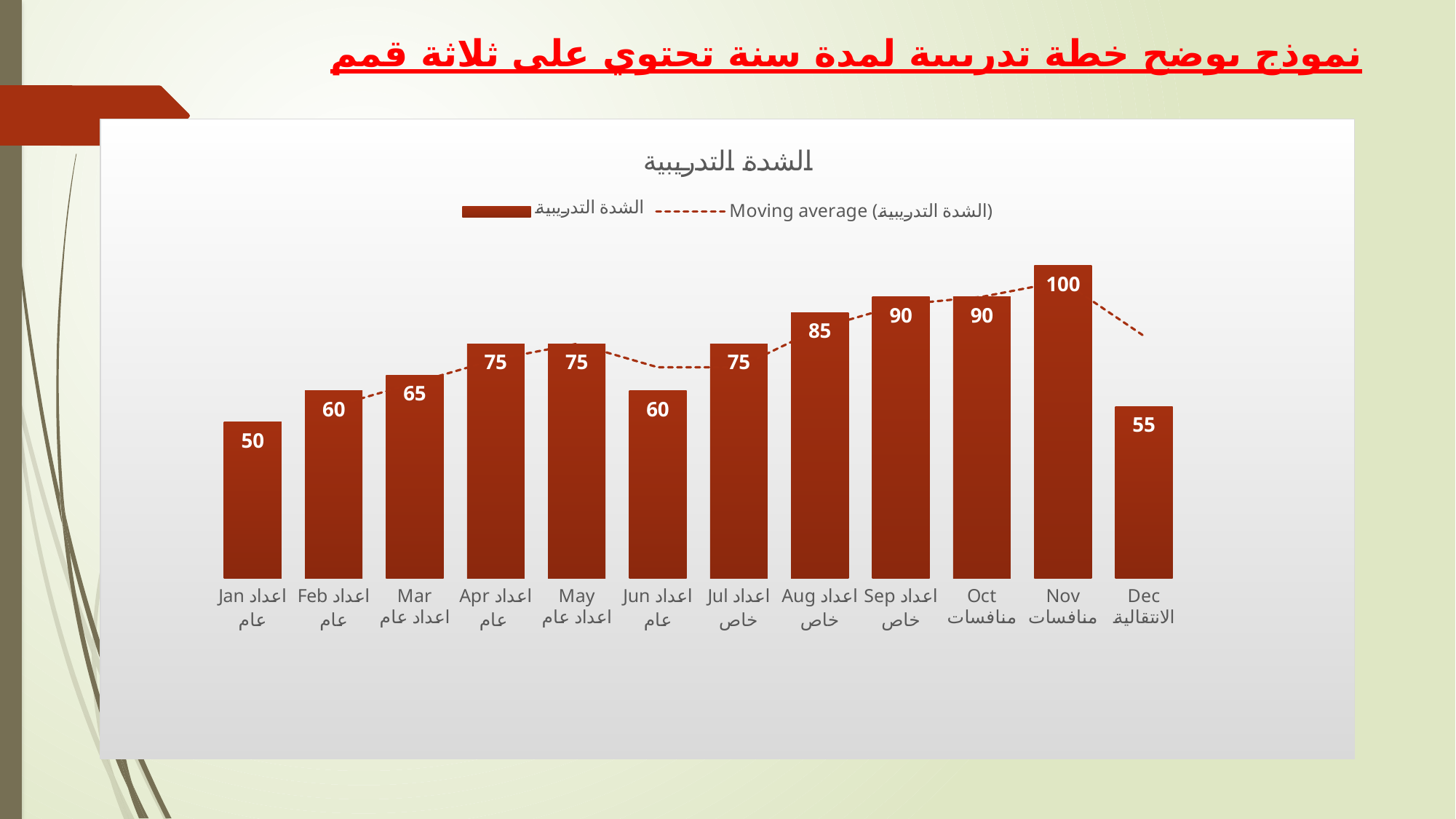
What kind of chart is shown on the slide? Bar chart What is the training intensity value for Nov? 100 What is the difference between the values for Nov and Dec? 45 What is the difference between the values for Jun and Jul? 15 What is the value shown for Jan? 50 Which month has the highest training intensity? Nov What is the value shown for Aug? 85 How many months (bars) are plotted in the chart? 12 How many series does the legend list? 2 Which month has the lowest training intensity? Jan What is the title of the chart? الشدة التدريبية Which is larger, the value for Mar or the value for Jun? Mar